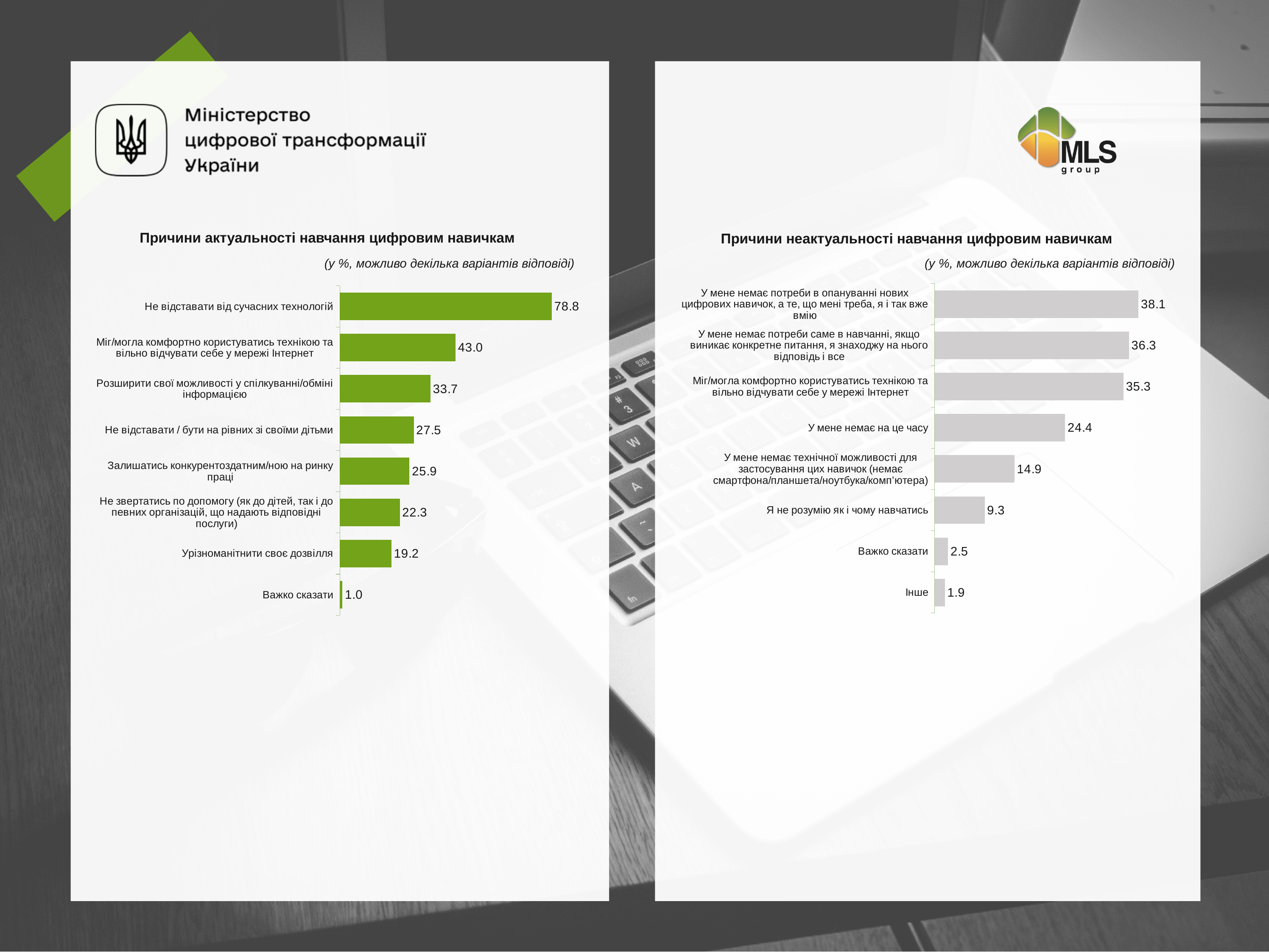
In the chart 'Причини неактуальності навчання цифровим навичкам', what is the value for 'У мене немає на це часу'? 24.4 In the chart 'Причини актуальності навчання цифровим навичкам', what is the difference between 'Не відставати від сучасних технологій' and 'Міг/могла комфортно користуватись технікою та вільно відчувати себе у мережі Інтернет'? 35.8 In the chart 'Причини неактуальності навчання цифровим навичкам', which is larger: 'Важко сказати' or 'Інше'? Важко сказати In the chart 'Причини актуальності навчання цифровим навичкам', what is the value for 'Урізноманітнити своє дозвілля'? 19.2 In the chart 'Причини неактуальності навчання цифровим навичкам', which category has the highest value? У мене немає потреби в опануванні нових цифрових навичок, а те, що мені треба, я і так вже вмію In the chart 'Причини актуальності навчання цифровим навичкам', how many categories are shown? 8 In the chart 'Причини актуальності навчання цифровим навичкам', which category has the lowest value? Важко сказати What colour are the bars in the chart 'Причини актуальності навчання цифровим навичкам'? Green In the chart 'Причини актуальності навчання цифровим навичкам', what is the value for 'Не відставати від сучасних технологій'? 78.8 What type of chart is 'Причини неактуальності навчання цифровим навичкам'? Bar chart In the chart 'Причини неактуальності навчання цифровим навичкам', what is the value for 'Я не розумію як і чому навчатись'? 9.3 In the chart 'Причини неактуальності навчання цифровим навичкам', what is the difference between 'У мене немає на це часу' and 'У мене немає технічної можливості для застосування цих навичок (немає смартфона/планшета/ноутбука/комп'ютера)'? 9.5